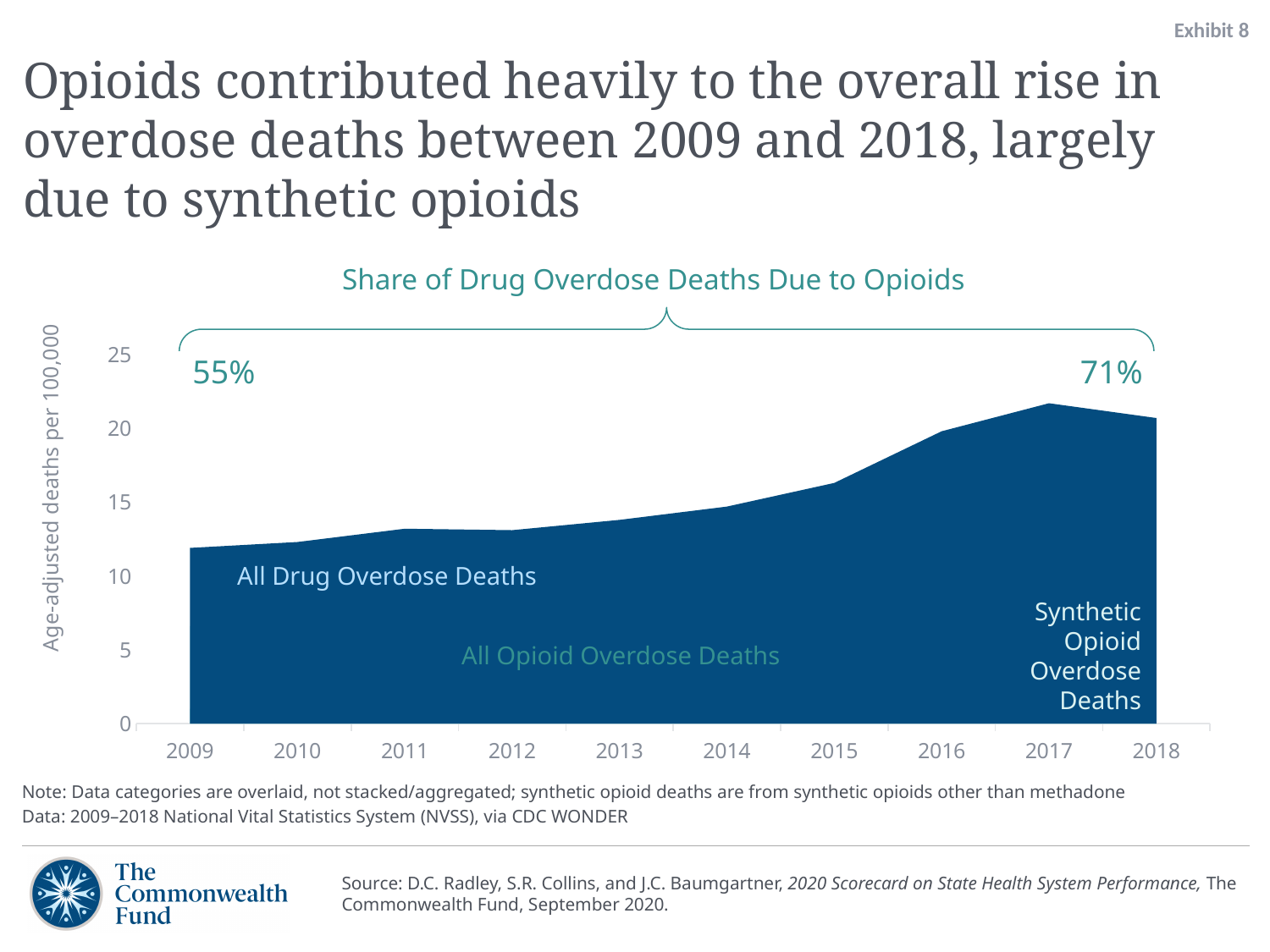
Is the value for All Drug Overdose Deaths in 2009 greater or less than 10? greater What share of drug overdose deaths was due to opioids in 2018? 71% What is the label on the y axis of the chart? Age-adjusted deaths per 100,000 Is the value for All Drug Overdose Deaths in 2017 greater or less than 20? greater By how many percentage points did the share of drug overdose deaths due to opioids change between 2009 and 2018? 16 percentage points In which year is the value for All Drug Overdose Deaths lowest? 2009 What share of drug overdose deaths was due to opioids in 2009? 55% In which year is the value for All Drug Overdose Deaths highest? 2017 How many years are shown along the x axis of the chart? 10 Which year has the larger value for All Drug Overdose Deaths, 2015 or 2016? 2016 What kind of chart is shown on the slide? Area chart Is the value for All Drug Overdose Deaths in 2015 greater or less than 20? less